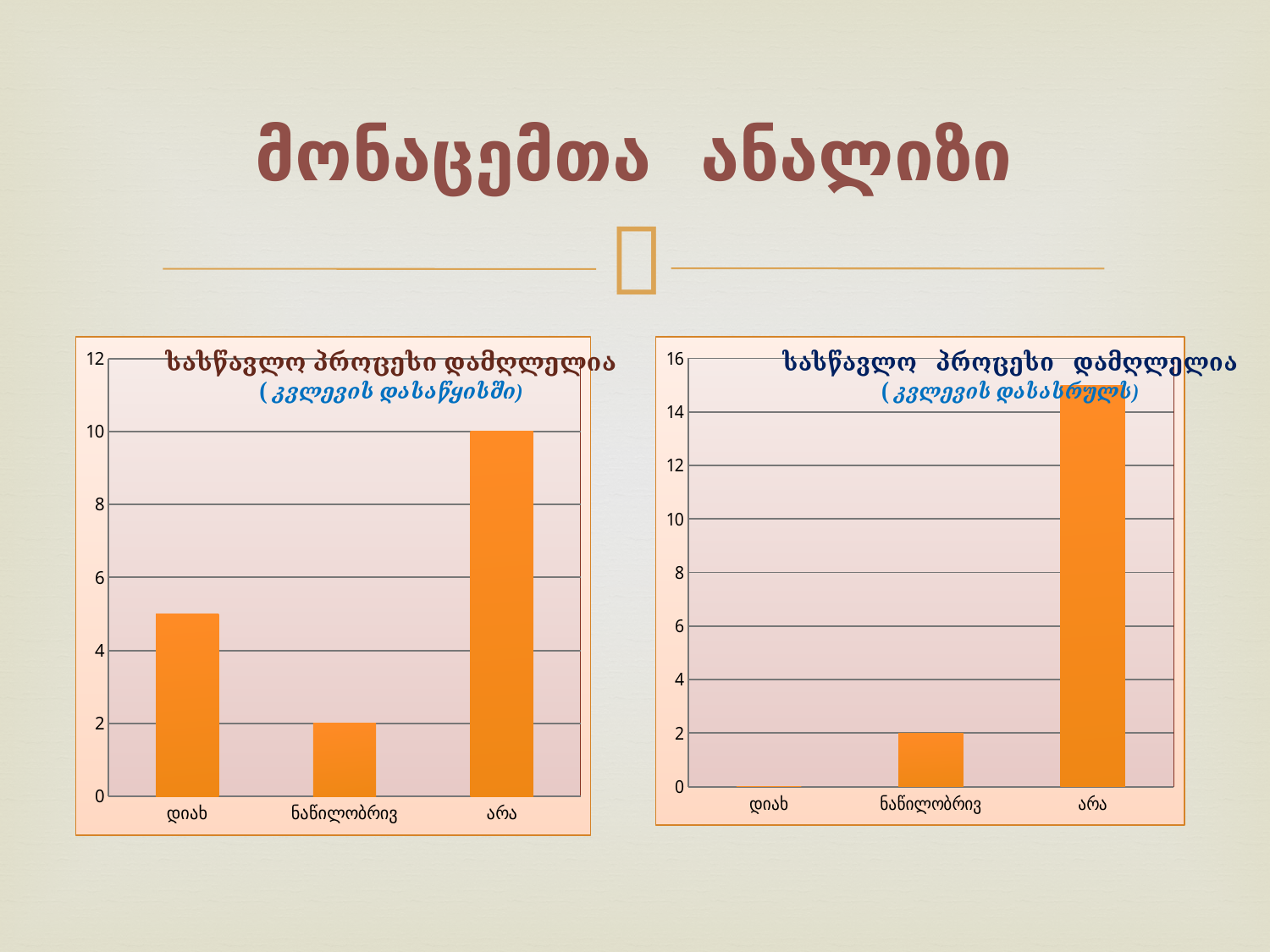
On the left chart (კვლევის დასაწყისში), what is the value for ნაწილობრივ? 2 How many categories are shown on the x axis of the left chart? 3 On the left chart, which category has the highest value? არა What type of chart is the right chart? bar chart On the right chart (კვლევის დასასრულს), what is the value for ნაწილობრივ? 2 On the right chart (კვლევის დასასრულს), what is the value for დიახ? 0 On the left chart, what is the difference between the values for არა and ნაწილობრივ? 8 On the left chart (კვლევის დასაწყისში), what is the value for არა? 10 On the left chart, which category has the lowest value? ნაწილობრივ On the left chart, is the value for დიახ greater or less than 4? greater On the right chart, is the value for არა greater or less than 14? greater On the right chart, which category has the highest value? არა